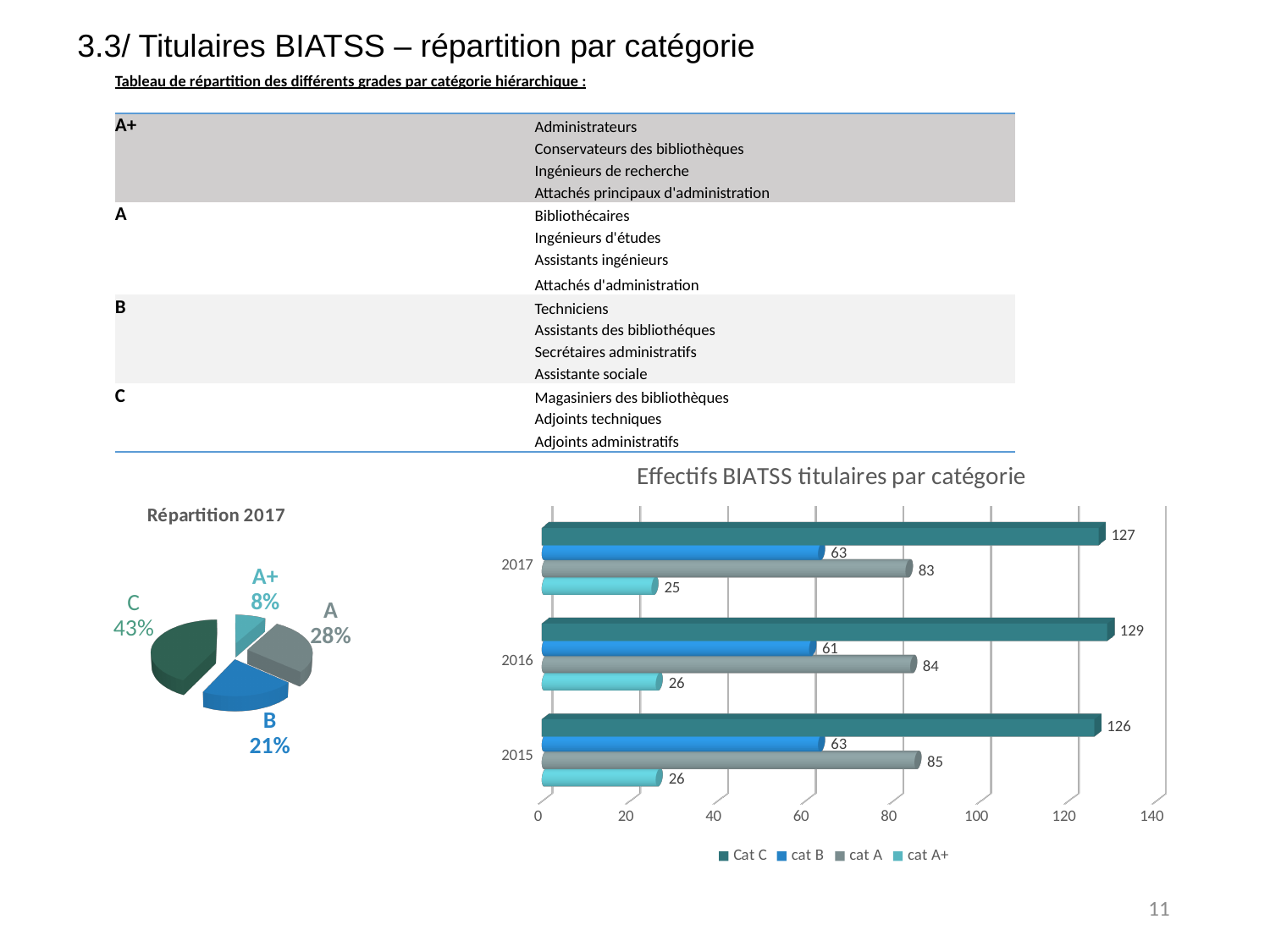
What kind of chart is 'Effectifs BIATSS titulaires par catégorie'? bar chart In the chart 'Effectifs BIATSS titulaires par catégorie', how many series does the legend list? 4 In the chart 'Effectifs BIATSS titulaires par catégorie', which is larger in 2016: cat B or cat A? cat A In the chart 'Effectifs BIATSS titulaires par catégorie', what is the value for cat A+ in 2016? 26 In the chart 'Effectifs BIATSS titulaires par catégorie', what is the difference between Cat C and cat B in 2017? 64 In the pie chart 'Répartition 2017', which category has the smallest slice? A+ In the chart 'Effectifs BIATSS titulaires par catégorie', how many years are shown on the vertical axis? 3 In the chart 'Effectifs BIATSS titulaires par catégorie', what is the value for Cat C in 2017? 127 In the chart 'Effectifs BIATSS titulaires par catégorie', which year has the highest value for Cat C? 2016 What kind of chart is 'Répartition 2017'? pie chart In the chart 'Effectifs BIATSS titulaires par catégorie', what is the value for cat A in 2015? 85 In the pie chart 'Répartition 2017', what share does category C have? 43%